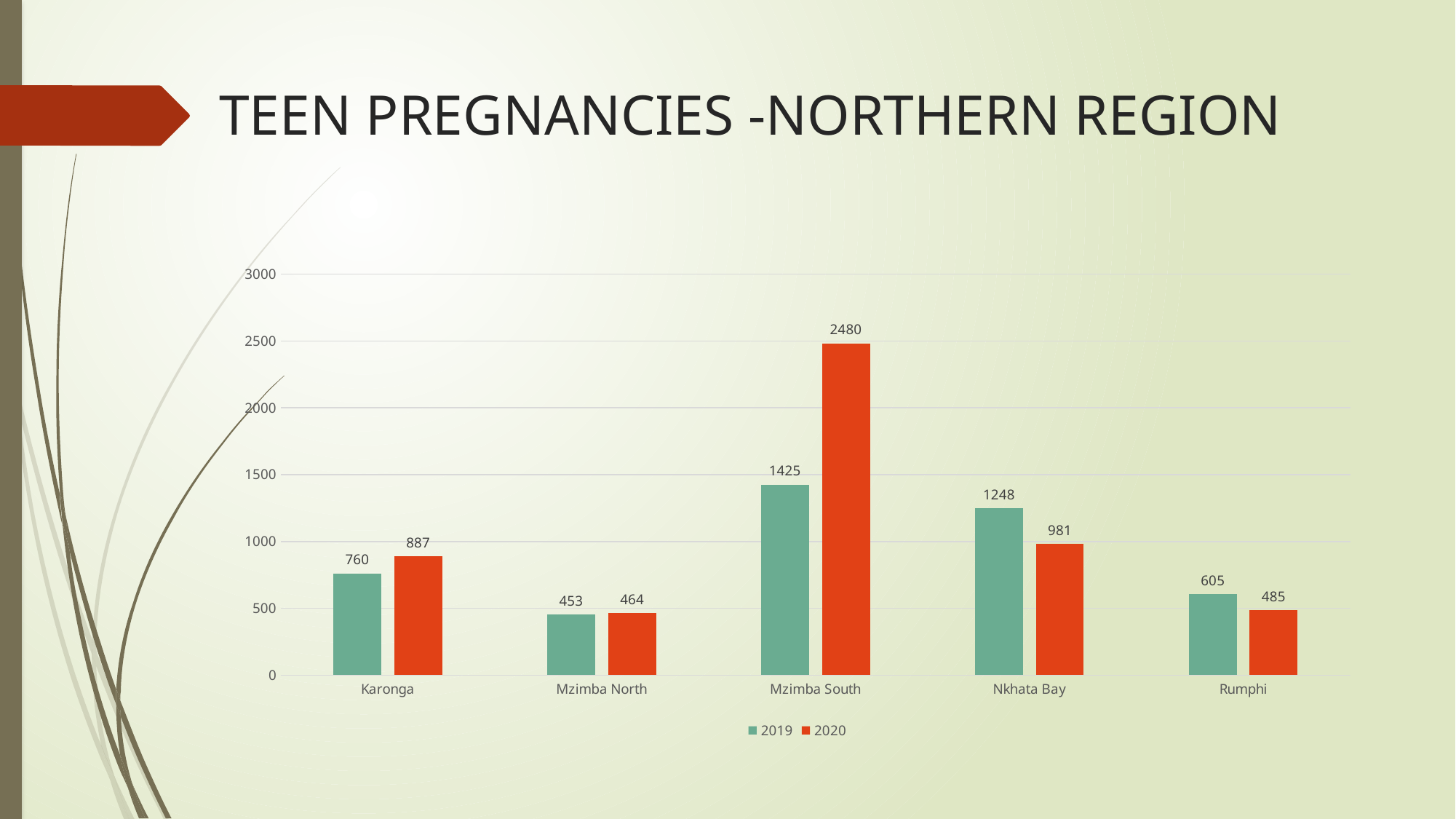
Which district had the highest number of teen pregnancies in 2019? Mzimba South What was the number of teen pregnancies in Mzimba South in 2020? 2480 What is the difference between the 2020 and 2019 values for Mzimba South? 1055 What was the number of teen pregnancies in Karonga in 2019? 760 What was the number of teen pregnancies in Rumphi in 2020? 485 What kind of chart is shown on the slide? Bar chart Which is larger for Rumphi, the 2019 value or the 2020 value? 2019 How many districts are shown on the x axis? 5 Which district had the lowest number of teen pregnancies in 2020? Mzimba North Is the 2019 value for Nkhata Bay greater or less than 1000? greater How many series does the legend list? 2 What is the difference between the 2019 and 2020 values for Nkhata Bay? 267